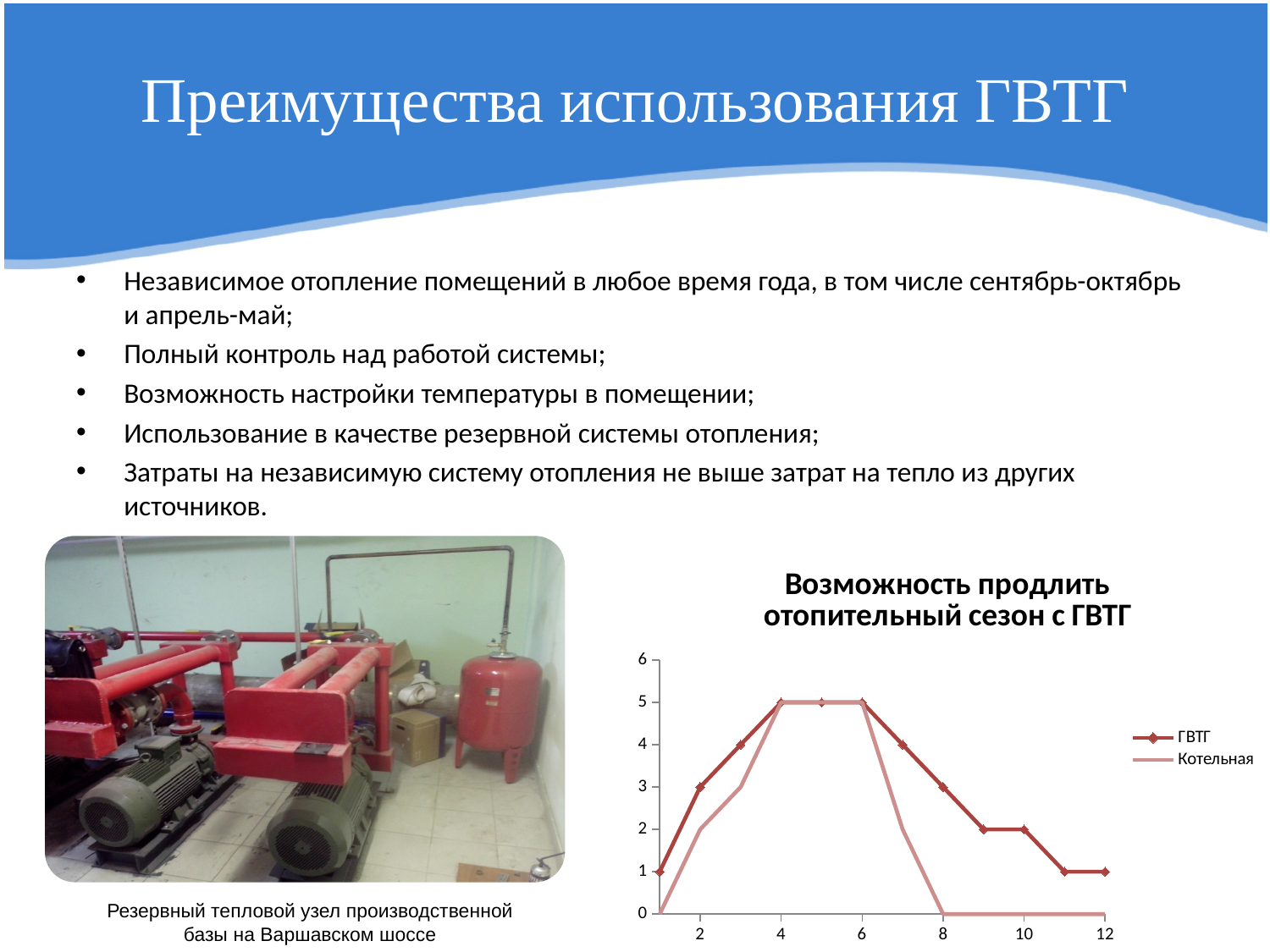
What is the value of the ГВТГ series at x = 4? 5 What is the value of the ГВТГ series at x = 12? 1 What is the difference between the ГВТГ and Котельная values at x = 12? 1 What kind of chart is shown on the slide? line chart What is the title of the chart? Возможность продлить отопительный сезон с ГВТГ At x = 2, which series has the higher value, ГВТГ or Котельная? ГВТГ What is the highest value reached by the ГВТГ series? 5 How many series does the chart legend list? 2 Is the value of the ГВТГ series at x = 9 greater or less than 3? less What is the value of the Котельная series at x = 12? 0 Does the ГВТГ series rise or fall between x = 6 and x = 12? fall What are the two series named in the chart legend? ГВТГ and Котельная